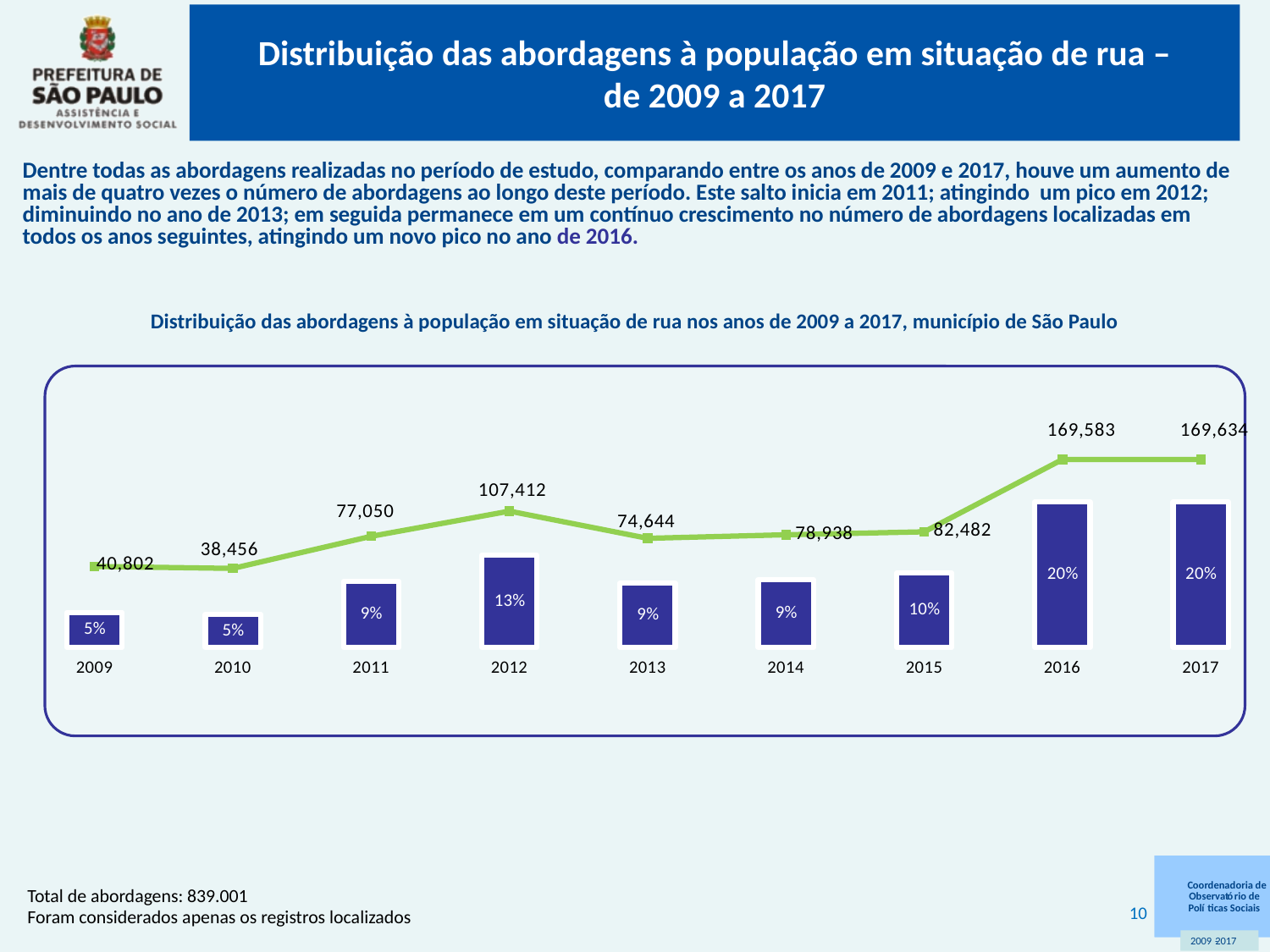
What is the difference between the line values for 2012 and 2013? 32,768 What is the number of abordagens shown on the line for 2012? 107,412 Does the line value rise or fall from 2009 to 2010? Fall What percentage is shown on the bar for 2015? 10% How many years are shown on the x axis of the chart? 9 Which year has the lowest number of abordagens on the line? 2010 What is the difference between the line values for 2016 and 2015? 87,101 What is the number of abordagens shown on the line for 2010? 38,456 Which is larger, the line value for 2011 or for 2014? 2014 Which year has the highest number of abordagens on the line? 2017 What kind of chart is shown on the slide? Combined bar and line chart What is the title of the chart? Distribuição das abordagens à população em situação de rua nos anos de 2009 a 2017, município de São Paulo